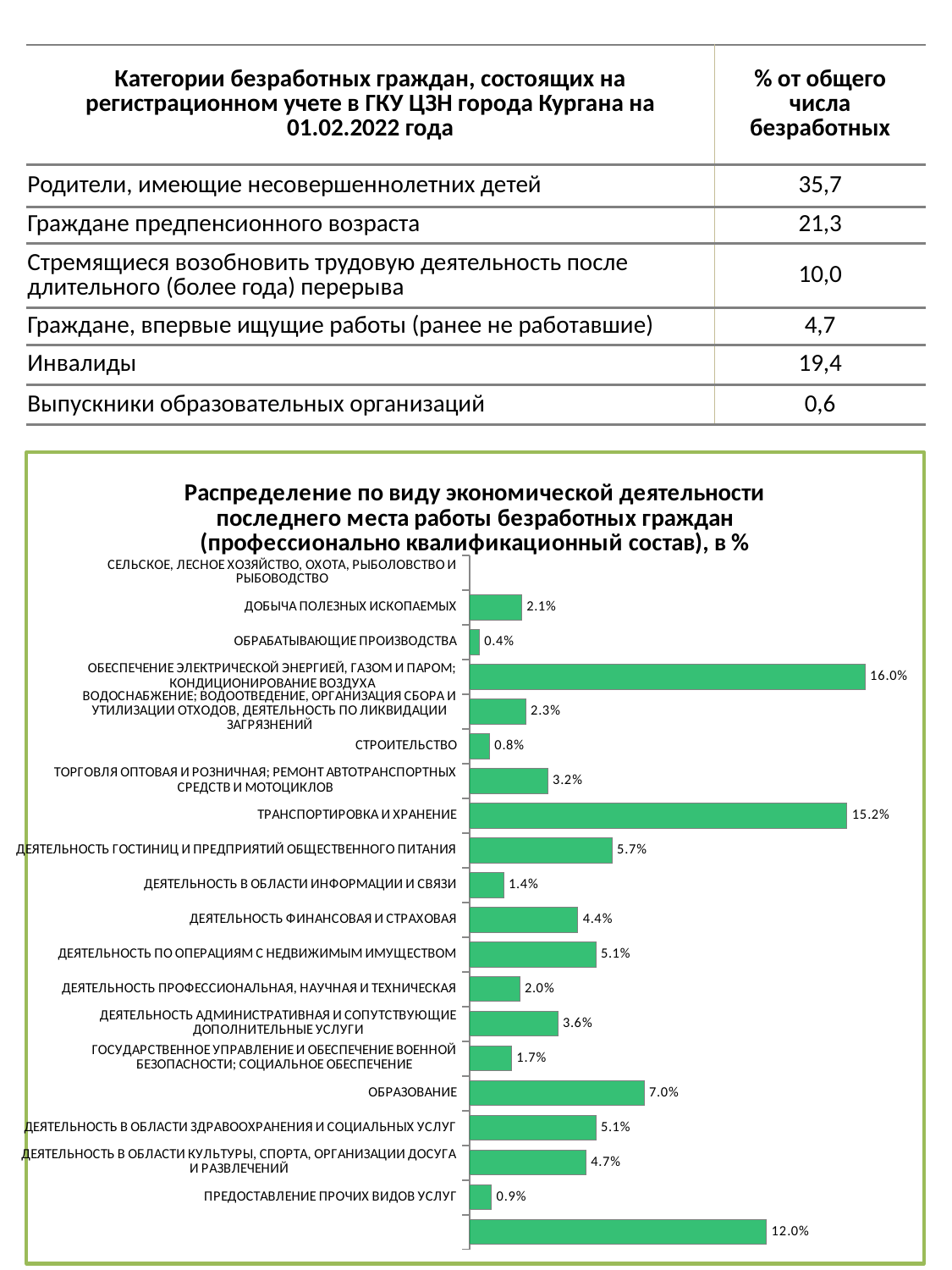
Which is larger: the value for ОБРАЗОВАНИЕ or for ДЕЯТЕЛЬНОСТЬ ГОСТИНИЦ И ПРЕДПРИЯТИЙ ОБЩЕСТВЕННОГО ПИТАНИЯ? ОБРАЗОВАНИЕ What is the value for ТРАНСПОРТИРОВКА И ХРАНЕНИЕ in the chart? 15.2% What is the value for ДЕЯТЕЛЬНОСТЬ АДМИНИСТРАТИВНАЯ И СОПУТСТВУЮЩИЕ ДОПОЛНИТЕЛЬНЫЕ УСЛУГИ in the chart? 3.6% What is the value for ОБРАЗОВАНИЕ in the chart? 7.0% What is the difference between the values for ОБЕСПЕЧЕНИЕ ЭЛЕКТРИЧЕСКОЙ ЭНЕРГИЕЙ, ГАЗОМ И ПАРОМ and ТРАНСПОРТИРОВКА И ХРАНЕНИЕ? 0.8% What is the value for СТРОИТЕЛЬСТВО in the chart? 0.8% Which category has the highest value in the chart? ОБЕСПЕЧЕНИЕ ЭЛЕКТРИЧЕСКОЙ ЭНЕРГИЕЙ, ГАЗОМ И ПАРОМ; КОНДИЦИОНИРОВАНИЕ ВОЗДУХА What is the difference between the values for ОБРАЗОВАНИЕ and ДЕЯТЕЛЬНОСТЬ В ОБЛАСТИ ЗДРАВООХРАНЕНИЯ И СОЦИАЛЬНЫХ УСЛУГ? 1.9% What colour are the bars in the chart? Green What type of chart is shown on the slide? Bar chart Which labeled category has the lowest value in the chart? ОБРАБАТЫВАЮЩИЕ ПРОИЗВОДСТВА What is the value for ДЕЯТЕЛЬНОСТЬ ФИНАНСОВАЯ И СТРАХОВАЯ in the chart? 4.4%